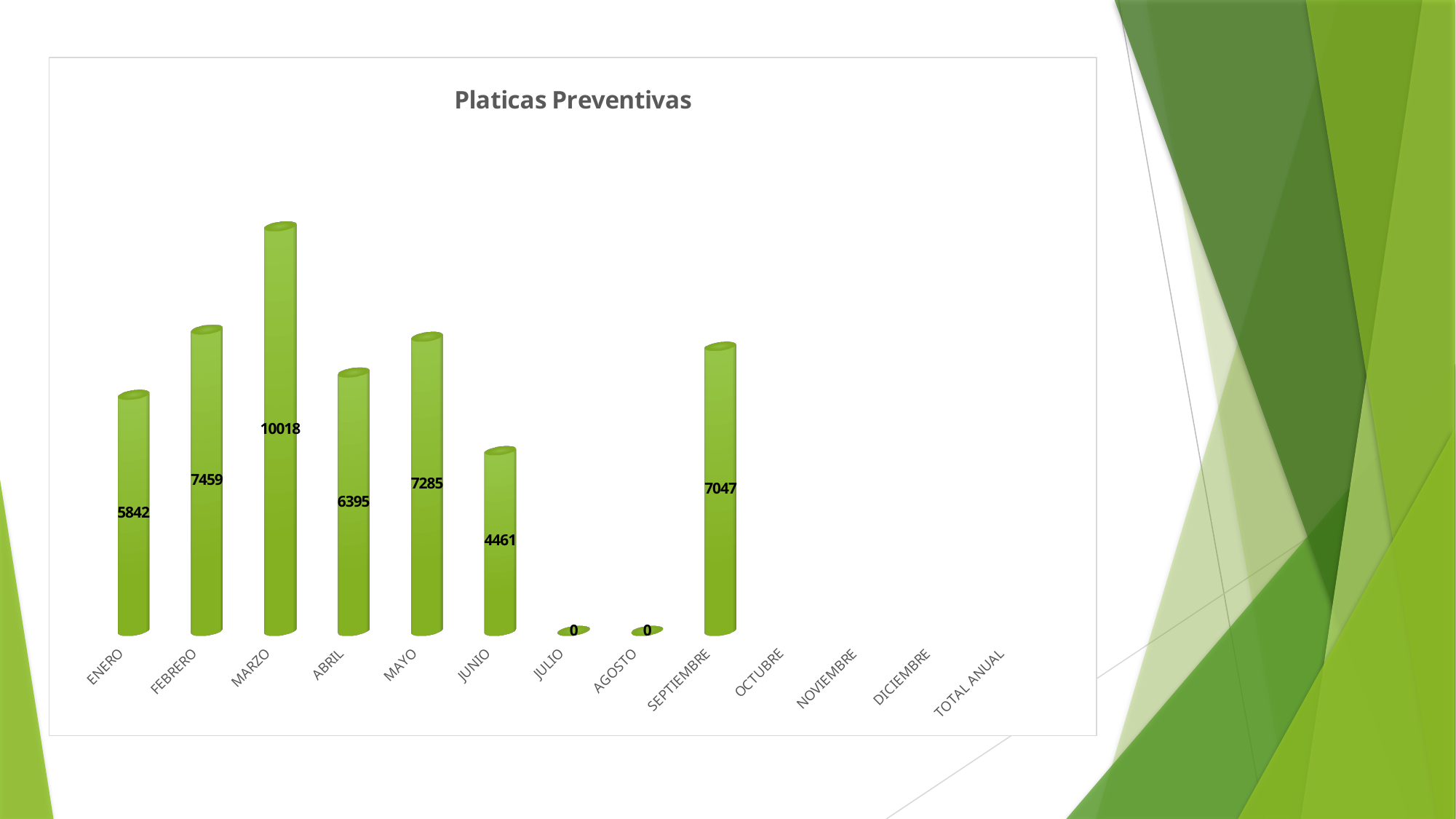
What is the value for JUNIO? 4461 How many categories are shown on the x axis? 13 Which is larger, the value for FEBRERO or the value for MAYO? FEBRERO What is the title of the chart? Platicas Preventivas What is the value for SEPTIEMBRE? 7047 Which month has the lowest non-zero value? JUNIO What kind of chart is this? bar chart What is the difference between the values for MAYO and ABRIL? 890 What is the difference between the values for MARZO and FEBRERO? 2559 What is the value for MARZO? 10018 Which month has the highest value? MARZO What is the value for JULIO? 0